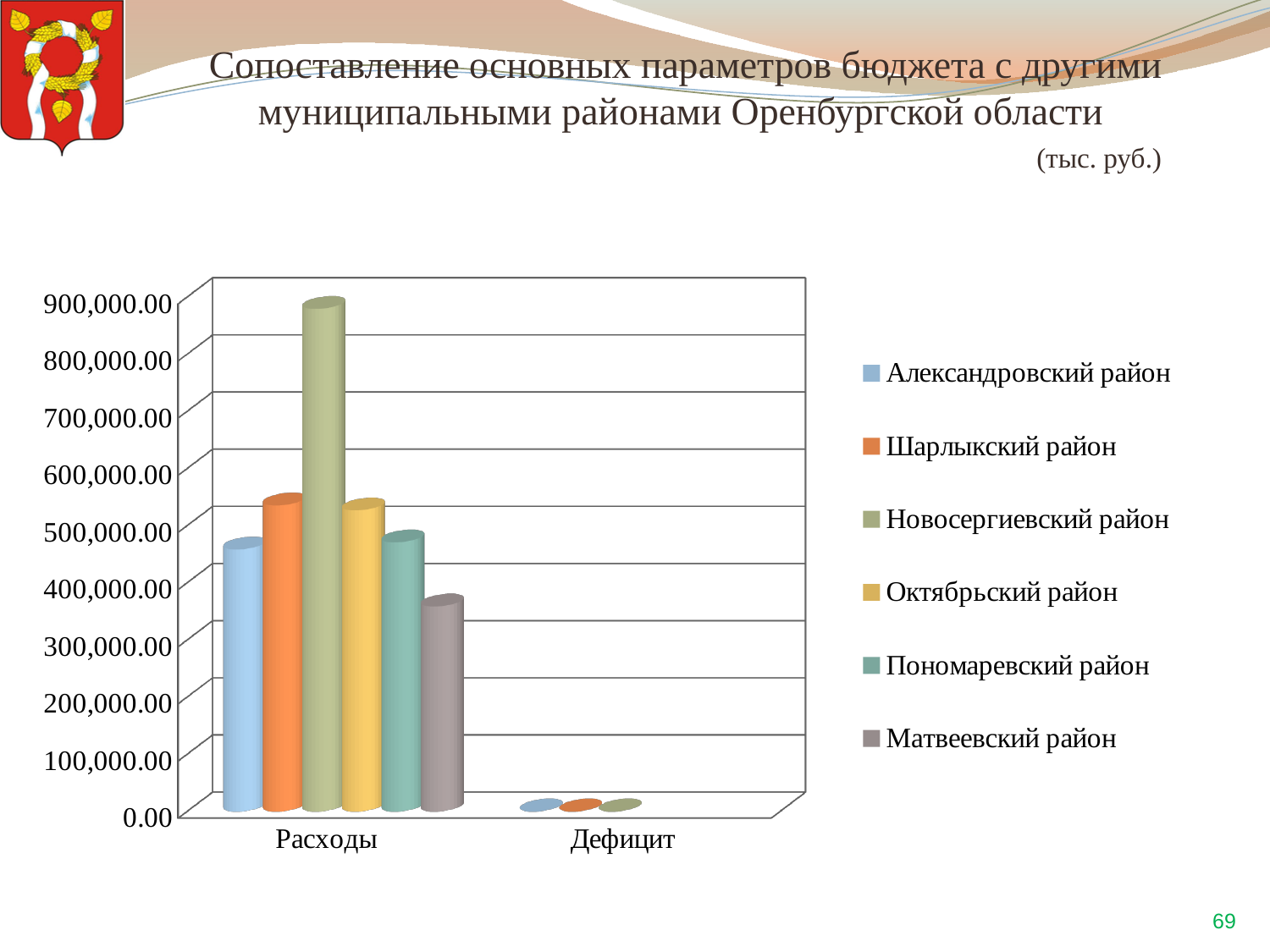
Is the Расходы value for Шарлыкский район greater or less than 500,000.00? greater Is the Расходы value for Новосергиевский район greater or less than 800,000.00? greater Which has the larger Расходы value: Шарлыкский район or Александровский район? Шарлыкский район In what units are the values on the chart given, according to the slide? тыс. руб. Which district has the lowest value for Расходы? Матвеевский район Which district has the highest value for Расходы? Новосергиевский район What kind of chart is shown on the slide? Bar chart Which category has the larger values overall: Расходы or Дефицит? Расходы How many series does the legend list? 6 Is the Расходы value for Александровский район greater or less than 500,000.00? less How many categories are shown on the x axis? 2